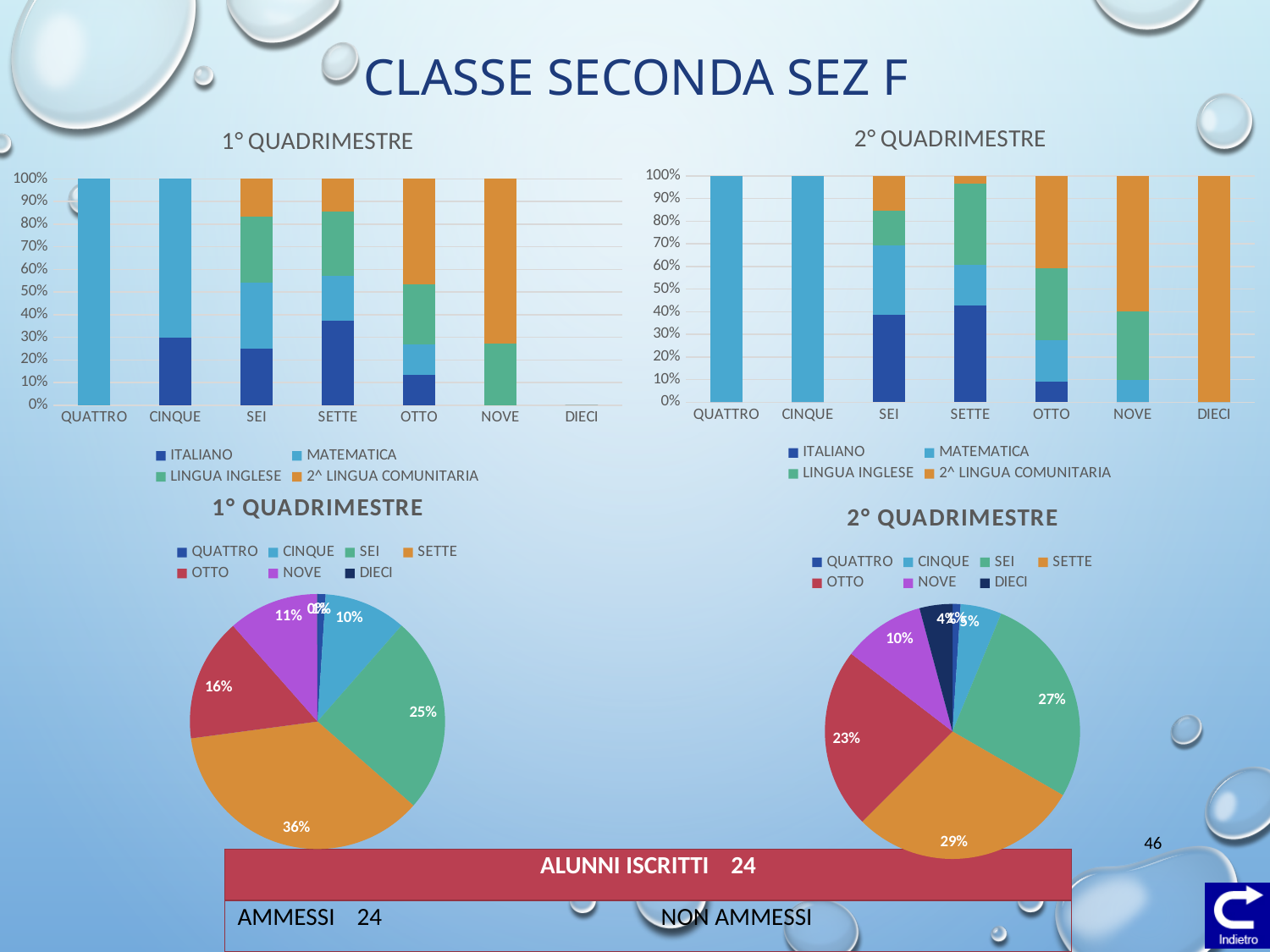
What kind of chart is the top-right 2° QUADRIMESTRE chart? Stacked bar chart In the 1° QUADRIMESTRE pie chart, which category has the largest slice? SETTE In the 2° QUADRIMESTRE pie chart, which is larger, the SEI slice or the OTTO slice? SEI In the 2° QUADRIMESTRE pie chart, what share does OTTO have? 23% In the 1° QUADRIMESTRE pie chart, what share does OTTO have? 16% In the 1° QUADRIMESTRE pie chart, what share does SETTE have? 36% How many series does the legend of the 1° QUADRIMESTRE stacked bar chart list? 4 How many categories are shown on the x axis of the 2° QUADRIMESTRE stacked bar chart? 7 In the 2° QUADRIMESTRE pie chart, what is the difference between the SEI and NOVE shares? 17% In the 1° QUADRIMESTRE stacked bar chart, is the ITALIANO value for SETTE greater or less than 30%? greater